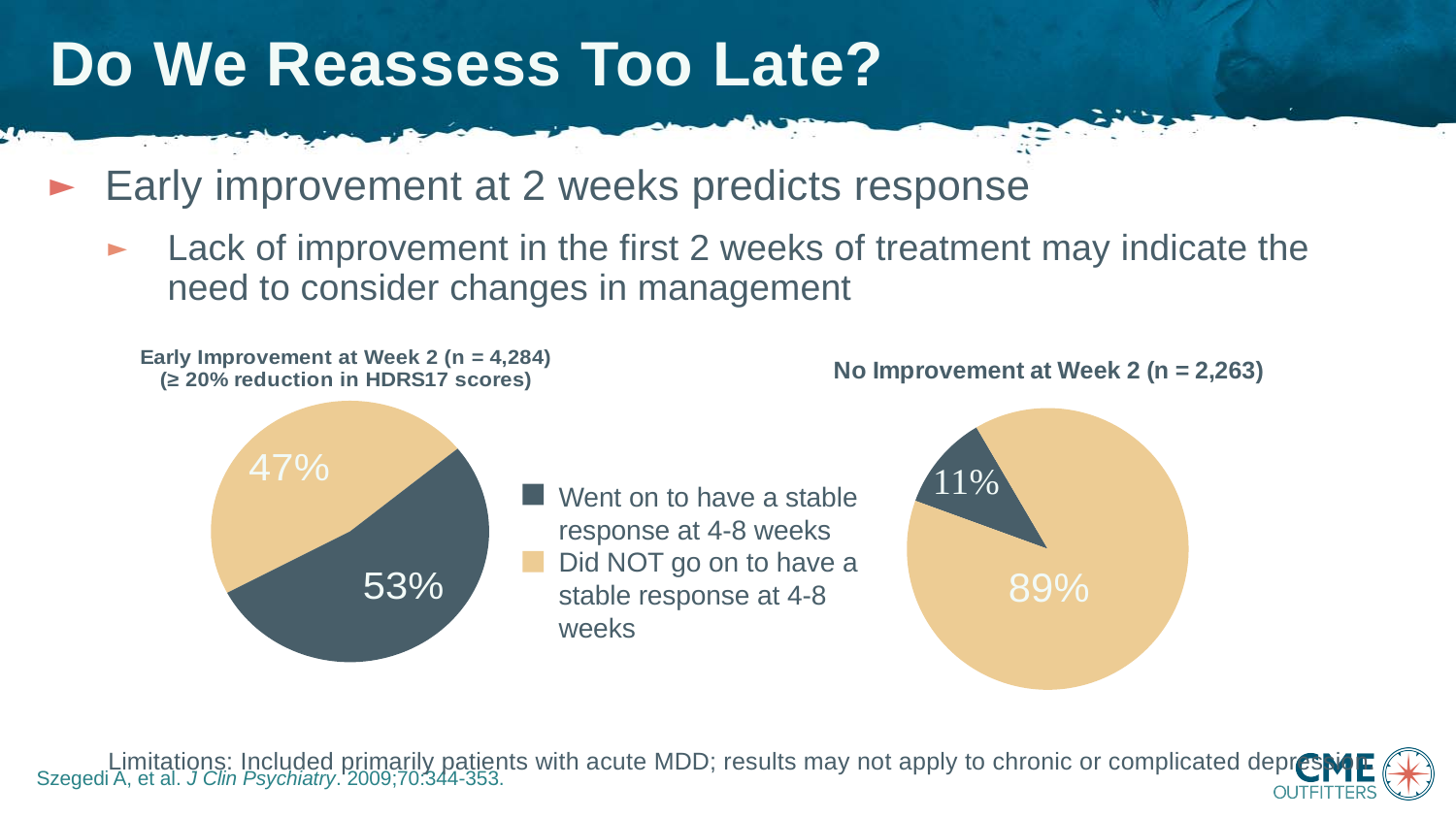
How many categories does the legend list? 2 Which chart has the larger share of patients who went on to have a stable response at 4-8 weeks? Early Improvement at Week 2 In the 'Early Improvement at Week 2' pie chart, what share of patients did NOT go on to have a stable response at 4-8 weeks? 47% In the 'No Improvement at Week 2' pie chart, which slice is larger: stable response or no stable response? Did NOT go on to have a stable response at 4-8 weeks In the 'Early Improvement at Week 2' pie chart, which slice is smaller? Did NOT go on to have a stable response at 4-8 weeks In the 'No Improvement at Week 2' pie chart, what share of patients did NOT go on to have a stable response at 4-8 weeks? 89% In the 'No Improvement at Week 2' pie chart, what share of patients went on to have a stable response at 4-8 weeks? 11% What is the sample size (n) shown in the title of the 'No Improvement at Week 2' pie chart? 2,263 What is the difference between the stable-response share in the 'Early Improvement at Week 2' chart and the stable-response share in the 'No Improvement at Week 2' chart? 42% How many pie charts are shown on the slide? 2 What kind of chart is used on this slide? Pie chart